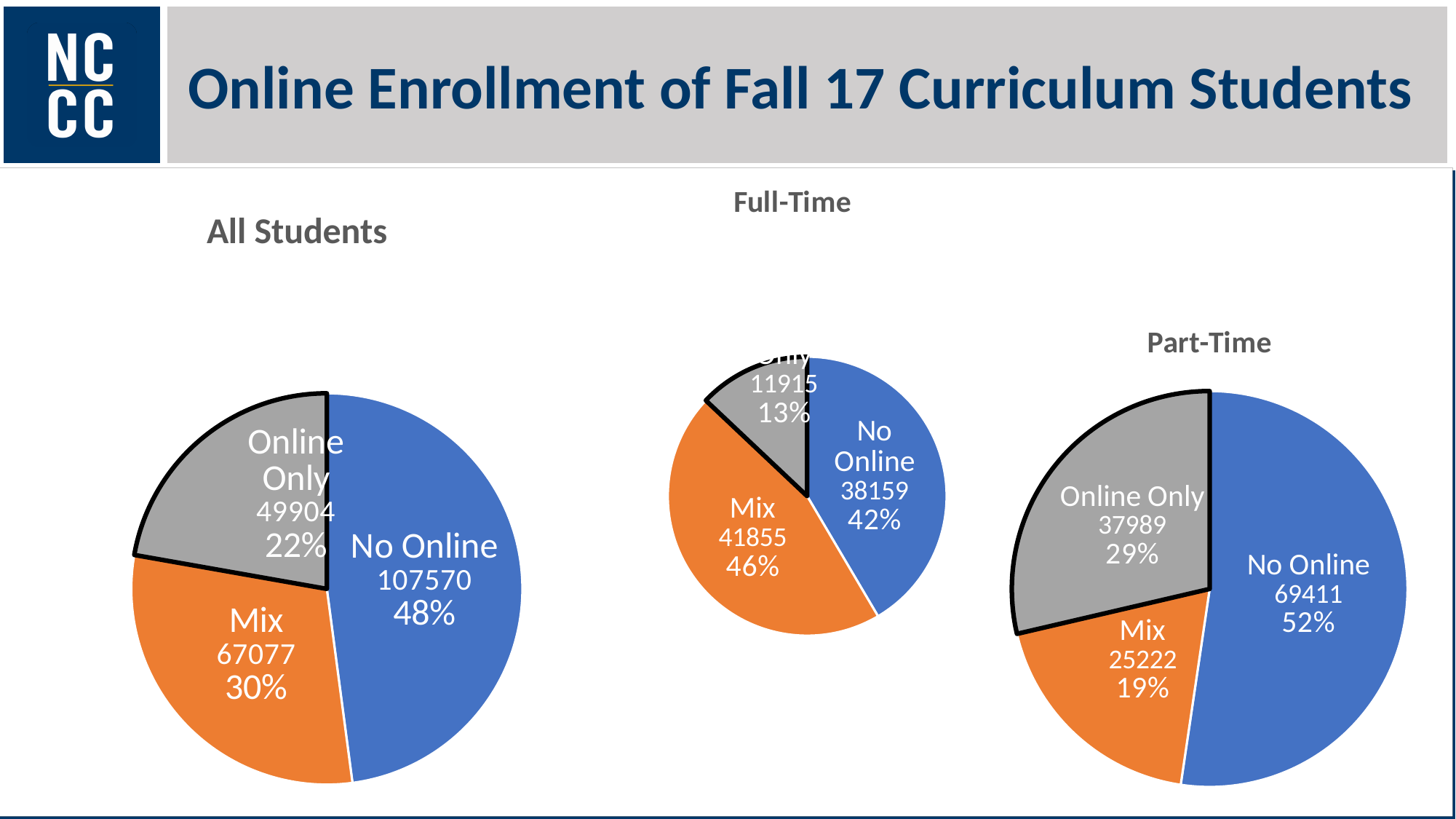
In the Full-Time chart, how many students are in the Mix category? 41855 In the All Students chart, what percentage of students are in the Mix category? 30% How many slices does the Part-Time chart have? 3 In the Part-Time chart, what is the difference in student count between No Online and Mix? 44189 In the Full-Time chart, what percentage of students are in the No Online category? 42% In the Part-Time chart, how many students are in the Online Only category? 37989 In the All Students chart, how many students are in the No Online category? 107570 In the Full-Time chart, which category has the largest share? Mix In the Part-Time chart, which is larger, Online Only or Mix? Online Only What kind of chart is used for the All Students data? Pie chart In the All Students chart, which category has the smallest share? Online Only How many pie charts are shown on the slide? 3